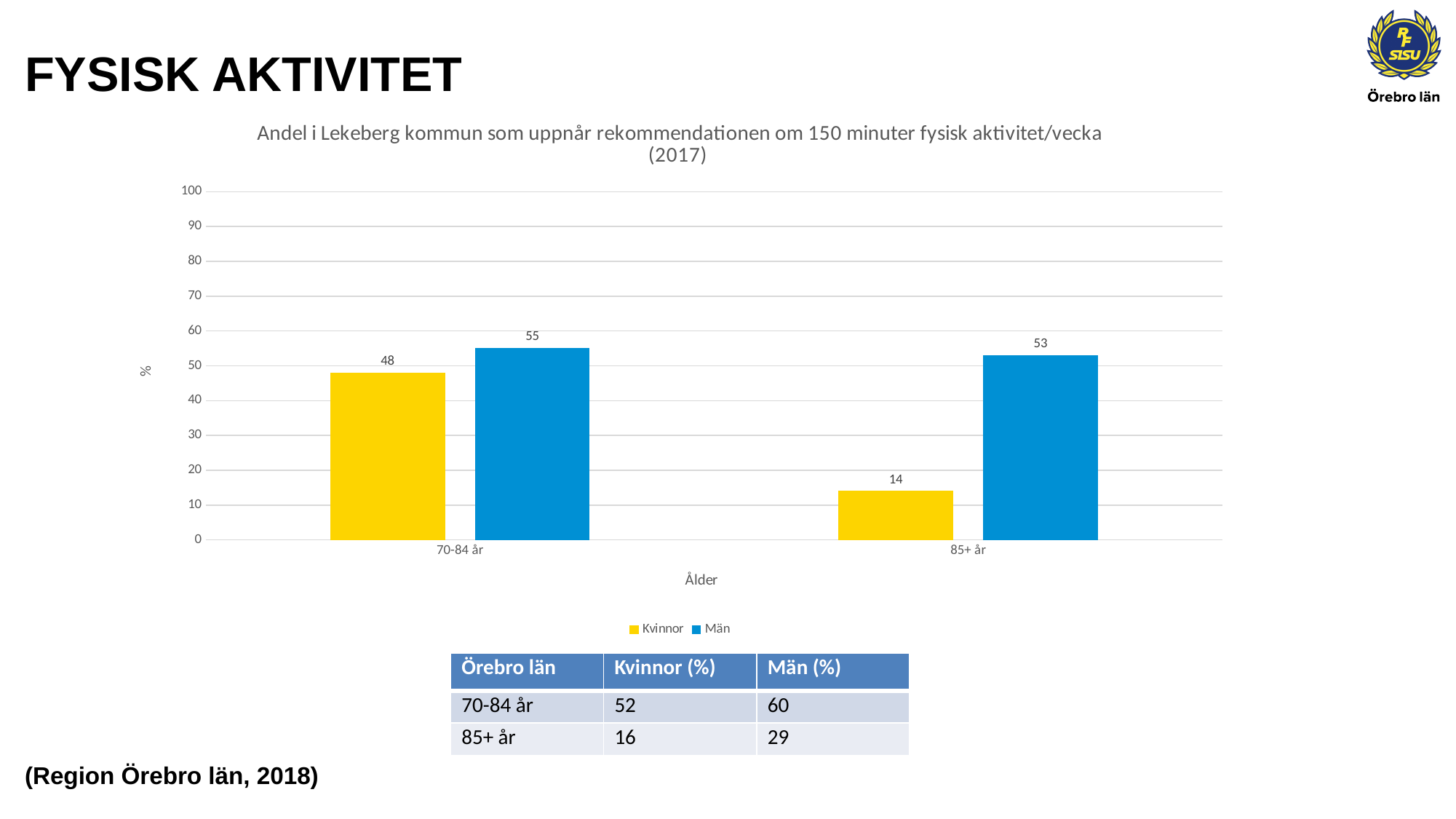
Which bar has the lowest value in the chart? Kvinnor, 85+ år What is the label of the x axis? Ålder How many series does the legend list? 2 What is the value for Kvinnor in the 70-84 år age group? 48 What is the difference between Män and Kvinnor in the 70-84 år age group? 7 How many age groups are shown on the x axis? 2 Which is larger, the value for Kvinnor in 70-84 år or the value for Kvinnor in 85+ år? Kvinnor in 70-84 år What kind of chart is shown on the slide? Bar chart What is the value for Män in the 85+ år age group? 53 What is the value for Kvinnor in the 85+ år age group? 14 What is the difference between Män and Kvinnor in the 85+ år age group? 39 Which bar has the highest value in the chart? Män, 70-84 år